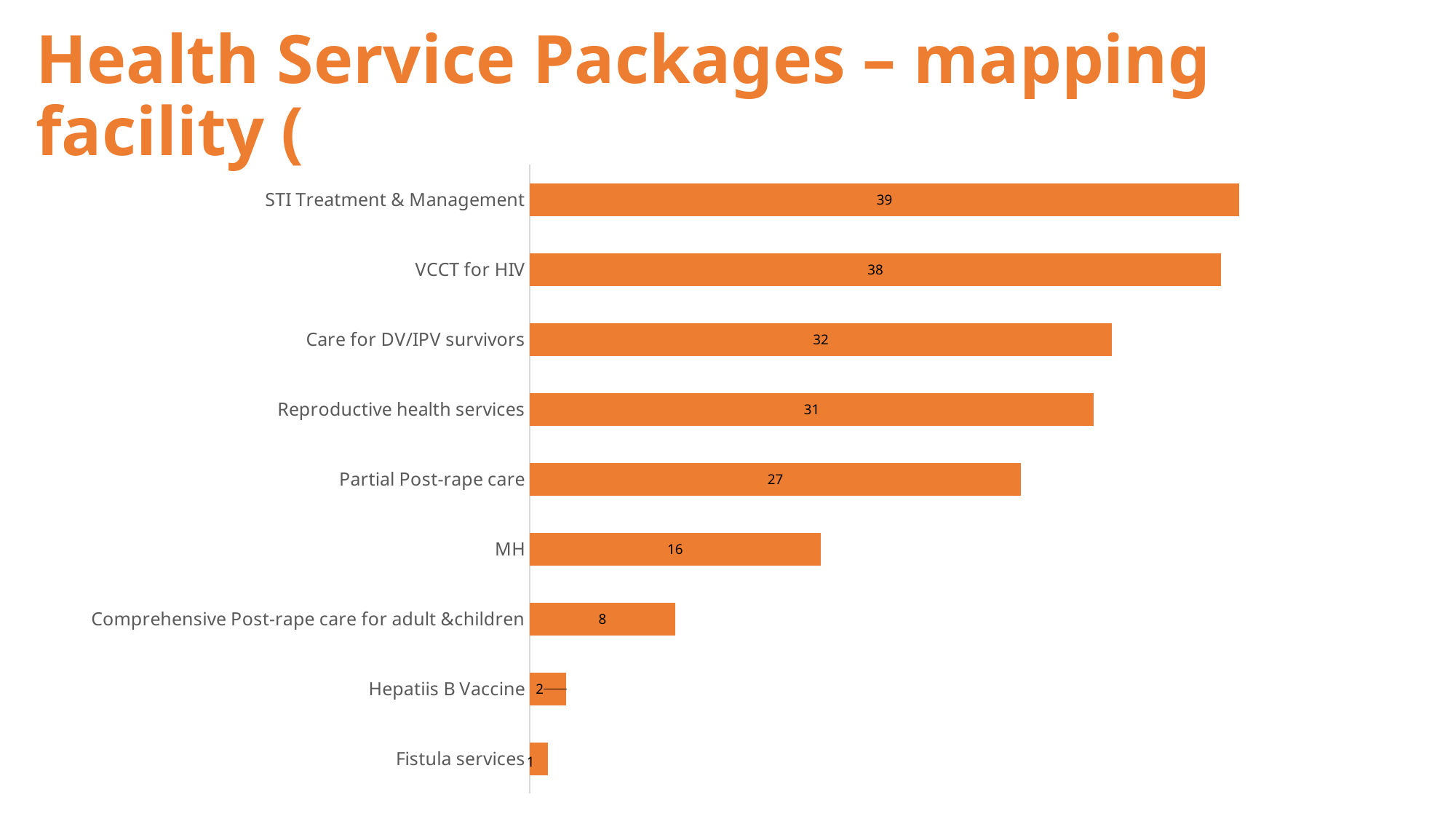
What is the value for Partial Post-rape care? 27 What kind of chart is shown on the slide? Bar chart Which category has the highest value? STI Treatment & Management What is the difference between the values for Reproductive health services and MH? 15 What is the value for Hepatiis B Vaccine? 2 What is the difference between the values for VCCT for HIV and Care for DV/IPV survivors? 6 What is the value for STI Treatment & Management? 39 Which category has the lowest value? Fistula services What is the value for MH? 16 Which is larger, the value for Partial Post-rape care or the value for MH? Partial Post-rape care What is the value for Comprehensive Post-rape care for adult &children? 8 How many categories are shown in the chart? 9